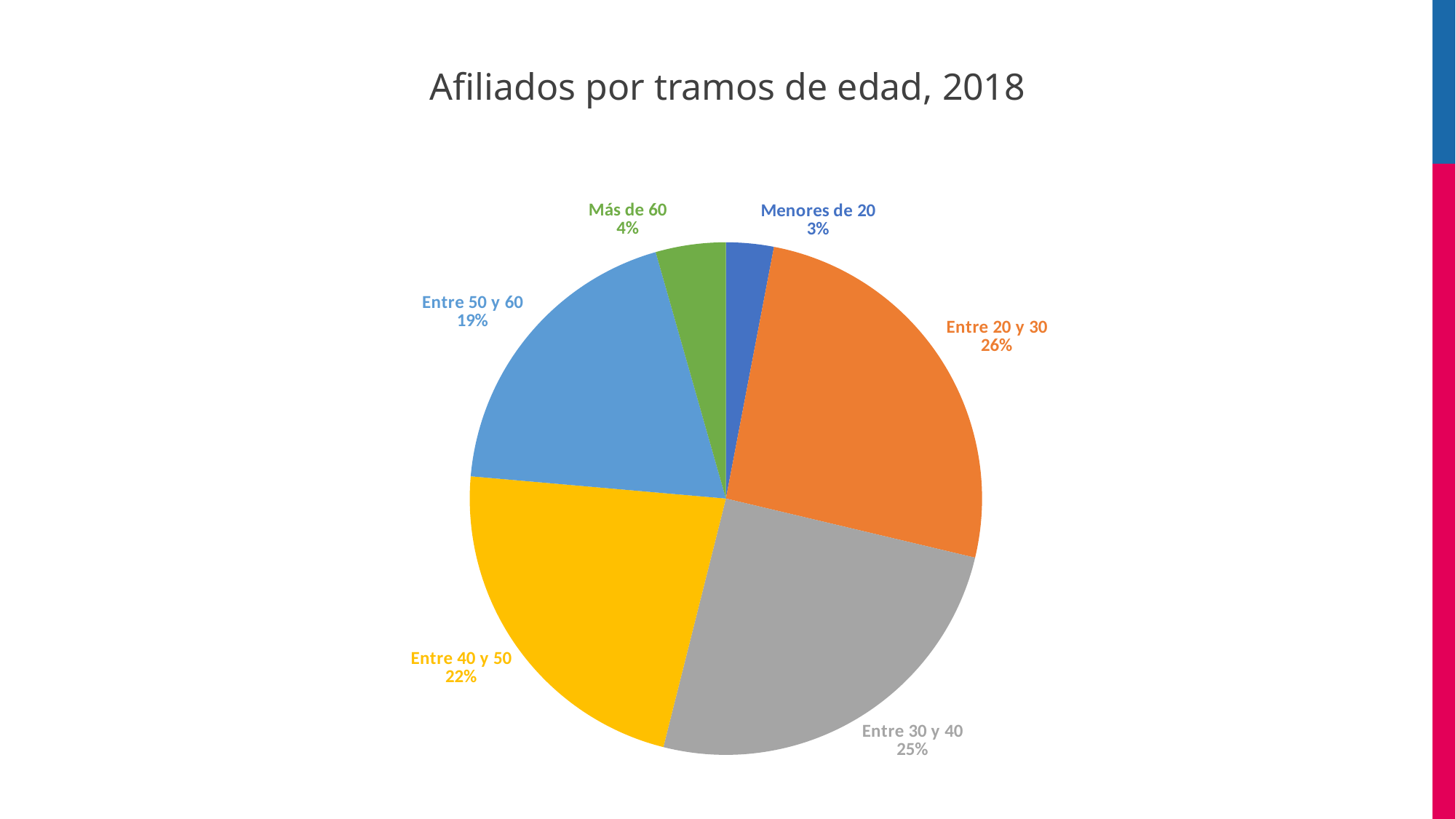
What is the title of the chart? Afiliados por tramos de edad, 2018 Which age group has the largest slice of the pie? Entre 20 y 30 What is the value shown for 'Más de 60'? 4% Which is larger, the slice for 'Entre 30 y 40' or the slice for 'Entre 40 y 50'? Entre 30 y 40 How many slices does the pie chart have? 6 What share of the pie does the 'Entre 20 y 30' slice represent? 26% What kind of chart is shown on the slide? Pie chart What is the value shown for 'Entre 50 y 60'? 19% What is the difference in percentage points between 'Entre 40 y 50' and 'Entre 50 y 60'? 3 What colour is the 'Entre 40 y 50' slice? Yellow What is the value shown for 'Menores de 20'? 3% Which age group has the smallest slice of the pie? Menores de 20